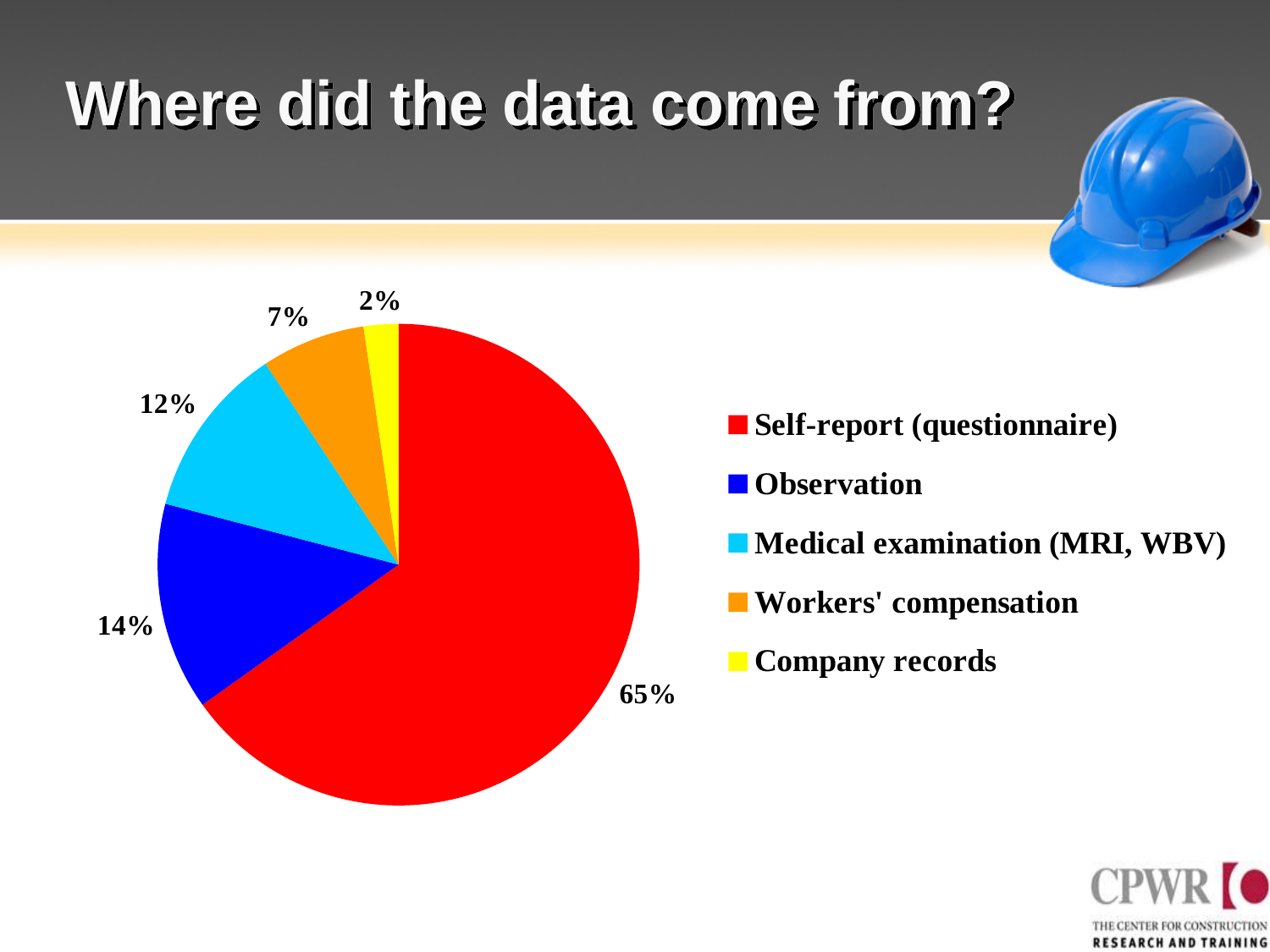
What is the value for Observation? 14% What is the difference between the shares for Observation and Medical examination (MRI, WBV)? 2% Which is larger, the share for Workers' compensation or the share for Company records? Workers' compensation What is the value for Company records? 2% What kind of chart is shown on the slide? pie chart What is the value for Workers' compensation? 7% Which data source has the largest share of the pie? Self-report (questionnaire) What share of the pie does Self-report (questionnaire) account for? 65% How many slices does the pie chart have? 5 What is the value for Medical examination (MRI, WBV)? 12% What colour is the slice for Medical examination (MRI, WBV)? light blue Which data source has the smallest share of the pie? Company records